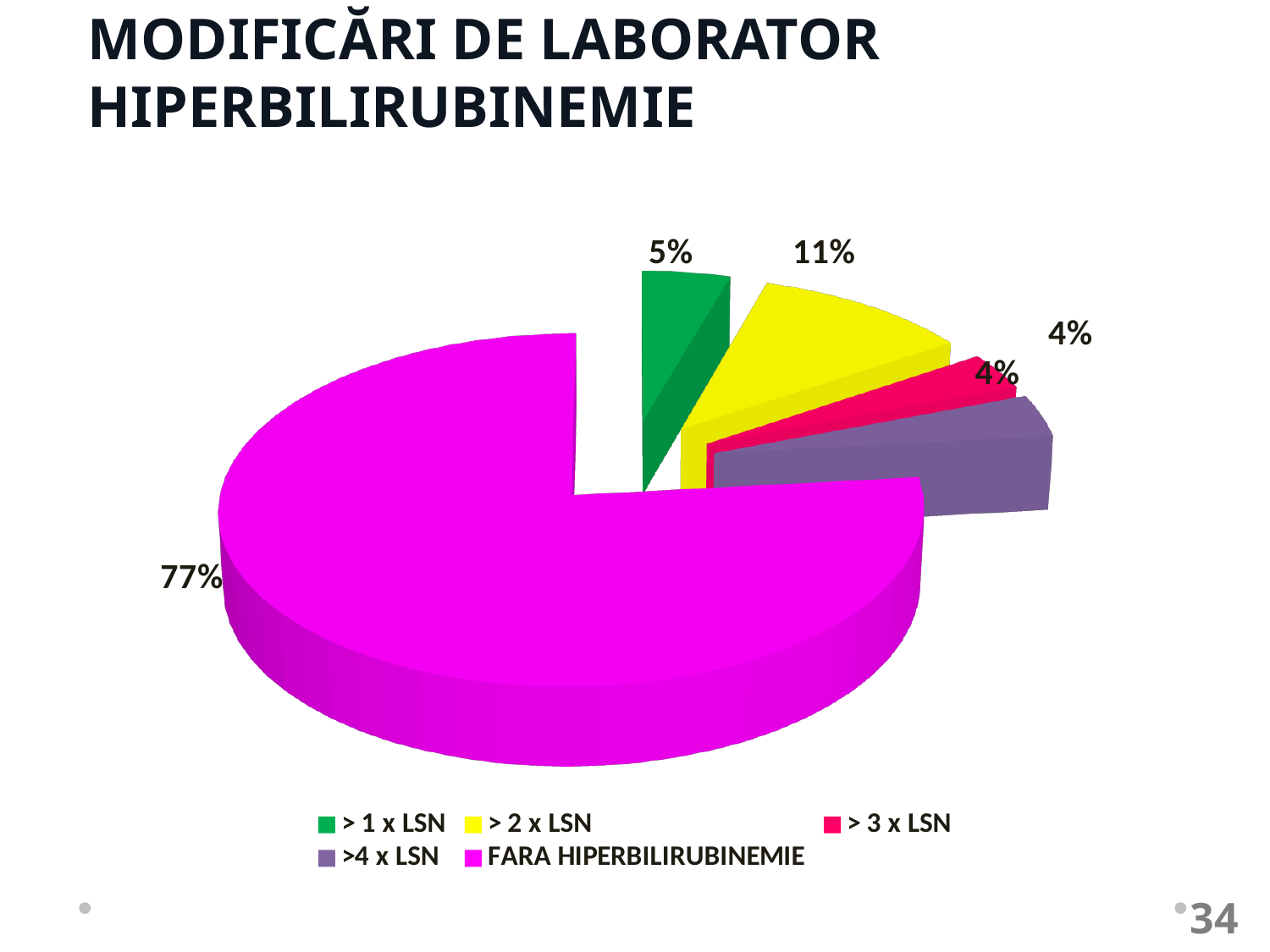
What is the value shown for the > 2 x LSN slice? 11% What is the value shown for the > 3 x LSN slice? 4% How many slices does the pie chart have? 5 Which category has the largest slice of the pie? FARA HIPERBILIRUBINEMIE Which slice is larger, > 1 x LSN or > 2 x LSN? > 2 x LSN Which legend entry is shown in green? > 1 x LSN What type of chart is shown on the slide? Pie chart What share of the pie does the FARA HIPERBILIRUBINEMIE slice represent? 77% What colour is the FARA HIPERBILIRUBINEMIE slice? Magenta What is the value shown for the > 1 x LSN slice? 5% What is the value shown for the >4 x LSN slice? 4% What is the difference in percentage points between the FARA HIPERBILIRUBINEMIE slice and the > 2 x LSN slice? 66 percentage points